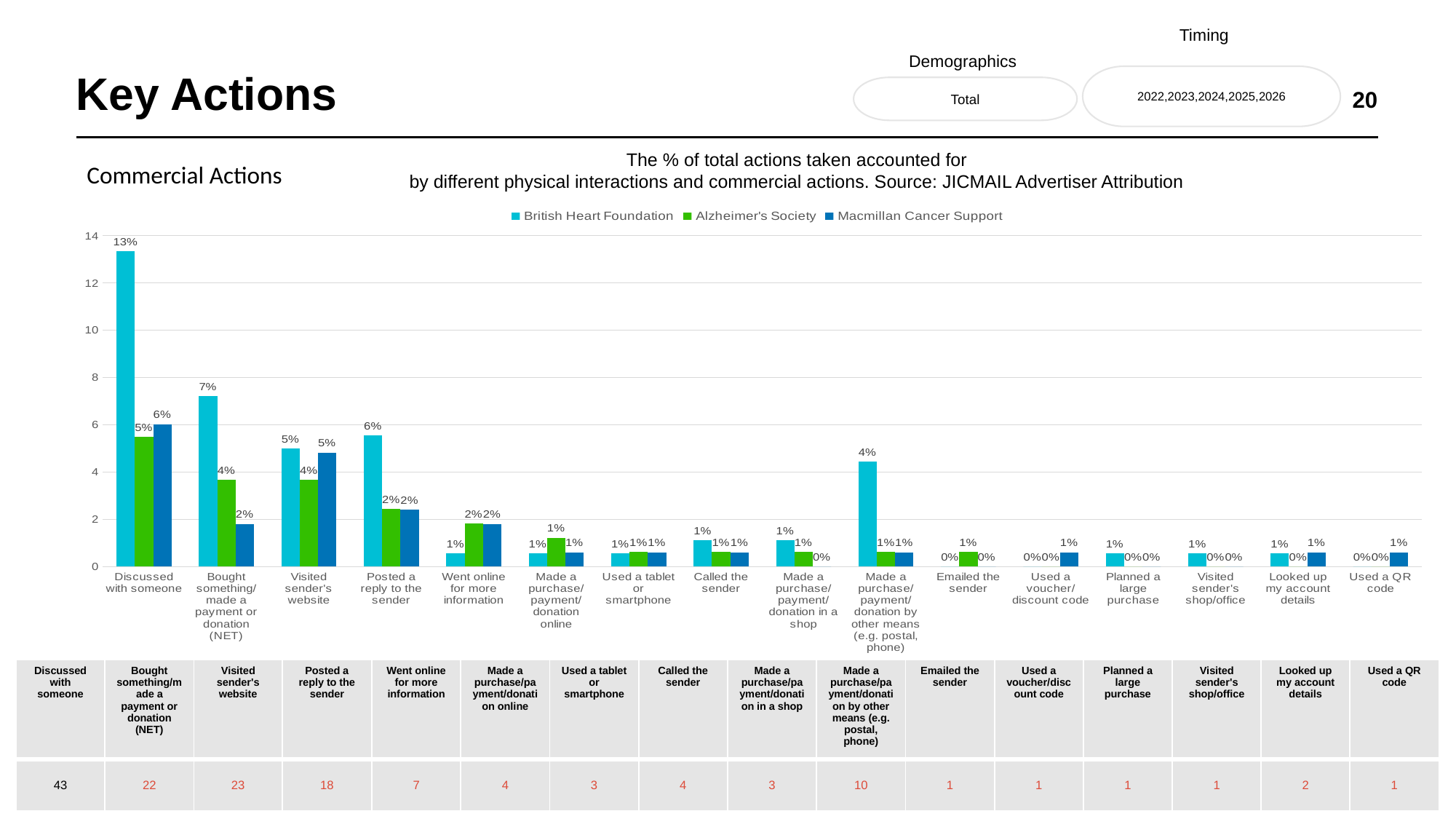
How many series does the legend list? 3 Which series is listed first in the chart legend? British Heart Foundation Is the British Heart Foundation value for 'Discussed with someone' greater or less than 12? greater What is the value for British Heart Foundation in the 'Made a purchase/payment/donation by other means (e.g. postal, phone)' category? 4% What is the value for Alzheimer's Society in the 'Bought something/made a payment or donation (NET)' category? 4% What kind of chart is shown on the slide? Bar chart Which category has the highest value for British Heart Foundation? Discussed with someone How many categories are shown on the x axis of the chart? 16 In the 'Bought something/made a payment or donation (NET)' category, which is larger: British Heart Foundation or Macmillan Cancer Support? British Heart Foundation What is the value for Macmillan Cancer Support in the 'Discussed with someone' category? 6% What is the value for British Heart Foundation in the 'Discussed with someone' category? 13% What is the difference between the British Heart Foundation and Alzheimer's Society values for 'Discussed with someone'? 8 percentage points